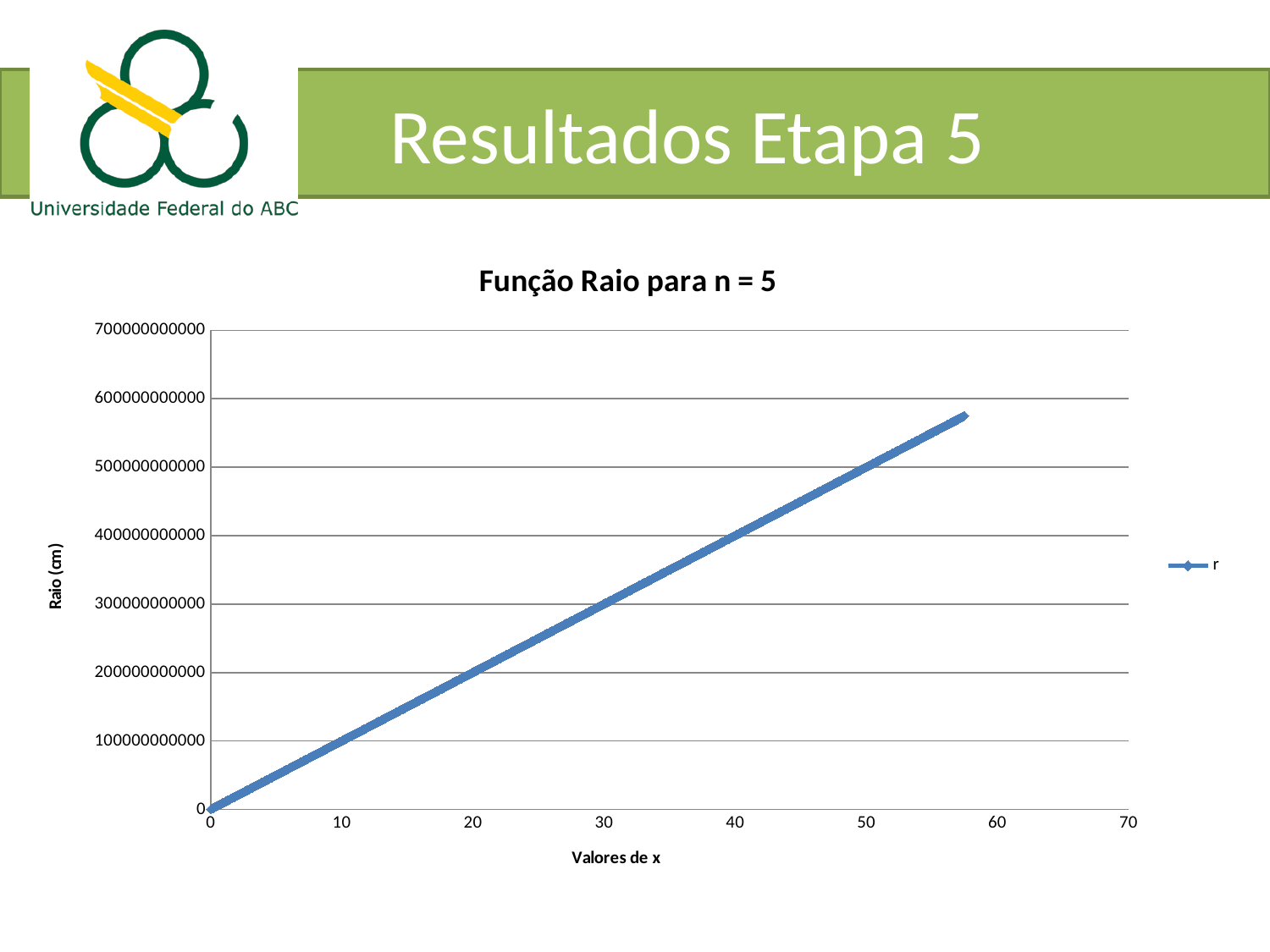
How many series does the legend list? 1 What is the title of the chart? Função Raio para n = 5 What is the value of r at x = 0? 0 What is the highest tick value shown on the y axis? 700000000000 Do the values of r rise or fall as x increases along the x axis? rise Is the highest plotted value of r greater or less than 600000000000? less Is the value of r at x = 40 greater or less than 300000000000? greater Is the value of r larger at x = 20 or at x = 40? x = 40 Is the value of r at x = 50 greater or less than 400000000000? greater What kind of chart is shown on the slide? line chart What is the name of the series shown in the legend? r